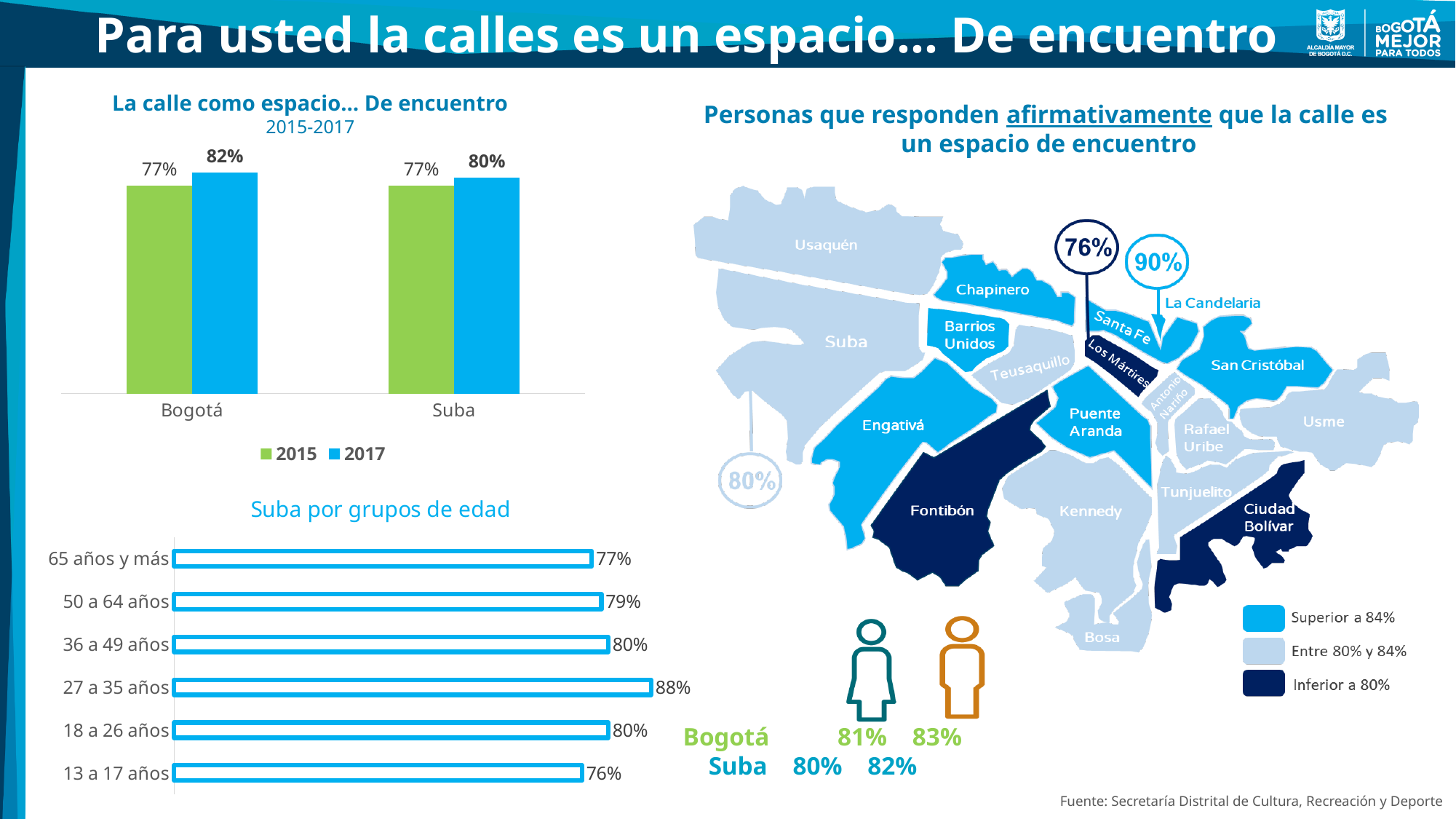
In the chart 'La calle como espacio… De encuentro', which is larger: Bogotá in 2017 or Suba in 2017? Bogotá in 2017 In the chart 'Suba por grupos de edad', what is the difference between the values for 27 a 35 años and 13 a 17 años? 12% How many series does the legend of the chart 'La calle como espacio… De encuentro' list? 2 In the chart 'La calle como espacio… De encuentro', what is the value for Suba in 2015? 77% In the chart 'La calle como espacio… De encuentro', what is the value for Bogotá in 2017? 82% In the chart 'Suba por grupos de edad', which age group has the lowest value? 13 a 17 años In the chart 'Suba por grupos de edad', which age group has the highest value? 27 a 35 años In the chart 'Suba por grupos de edad', what is the value for 50 a 64 años? 79% What kind of chart is 'La calle como espacio… De encuentro'? Bar chart How many age groups are shown in the chart 'Suba por grupos de edad'? 6 In the chart 'Suba por grupos de edad', what is the value for 27 a 35 años? 88% In the chart 'La calle como espacio… De encuentro', what is the difference between the 2017 and 2015 values for Bogotá? 5%